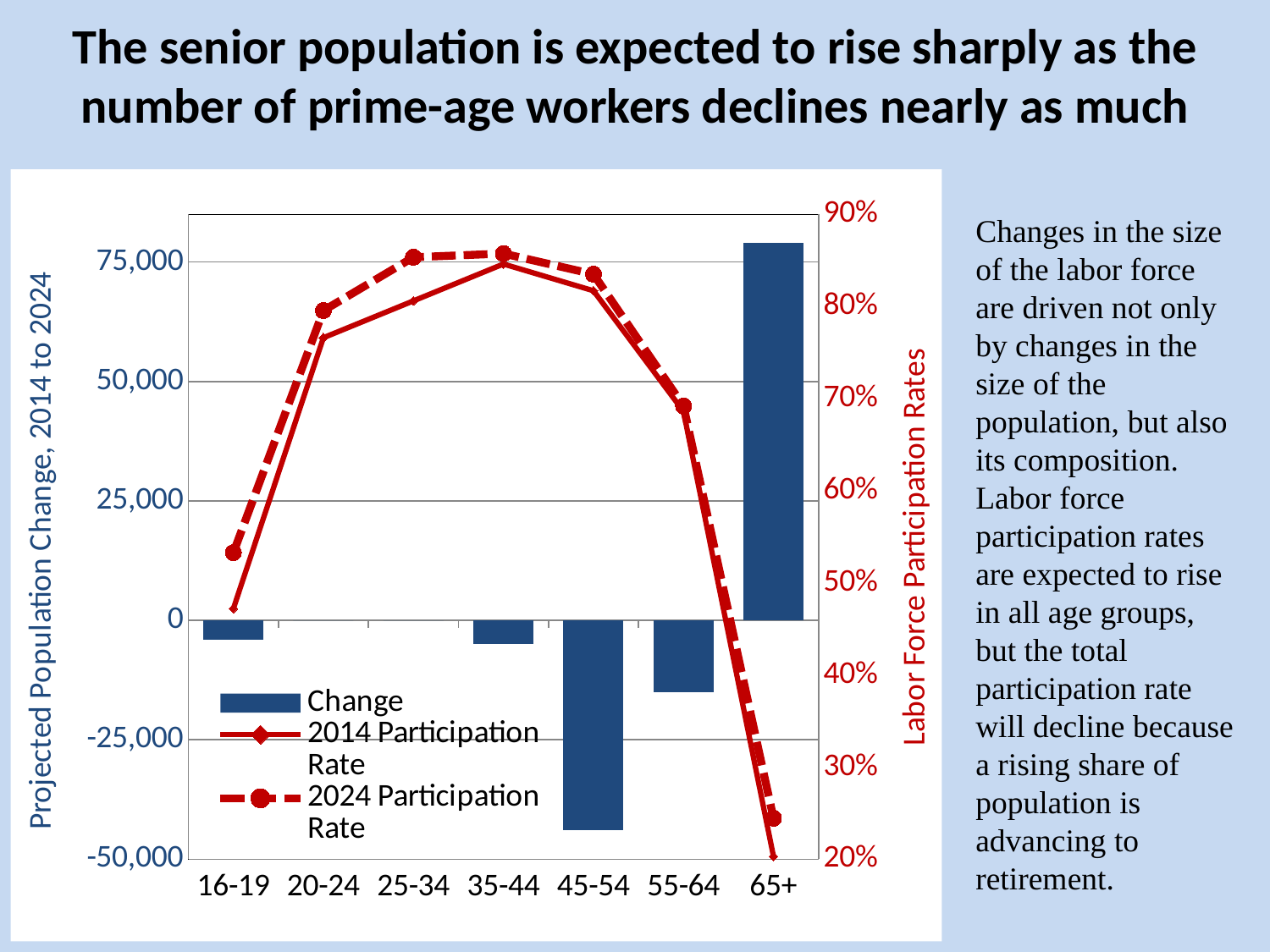
Is the projected population change for the 65+ age group greater or less than 75,000? greater Does the 2014 Participation Rate rise or fall from the 35-44 age group to the 65+ age group? fall Is the 2024 Participation Rate for the 65+ age group greater or less than 30%? less What kind of chart is shown on the slide? Combination bar and line chart How many age groups are shown on the x axis of the chart? 7 For the 16-19 age group, which is higher: the 2014 Participation Rate or the 2024 Participation Rate? 2024 Participation Rate Which age group has the highest projected population change bar? 65+ Is the 2014 Participation Rate for the 16-19 age group greater or less than 50%? less How many series does the chart's legend list? 3 Which age group has the lowest (most negative) projected population change bar? 45-54